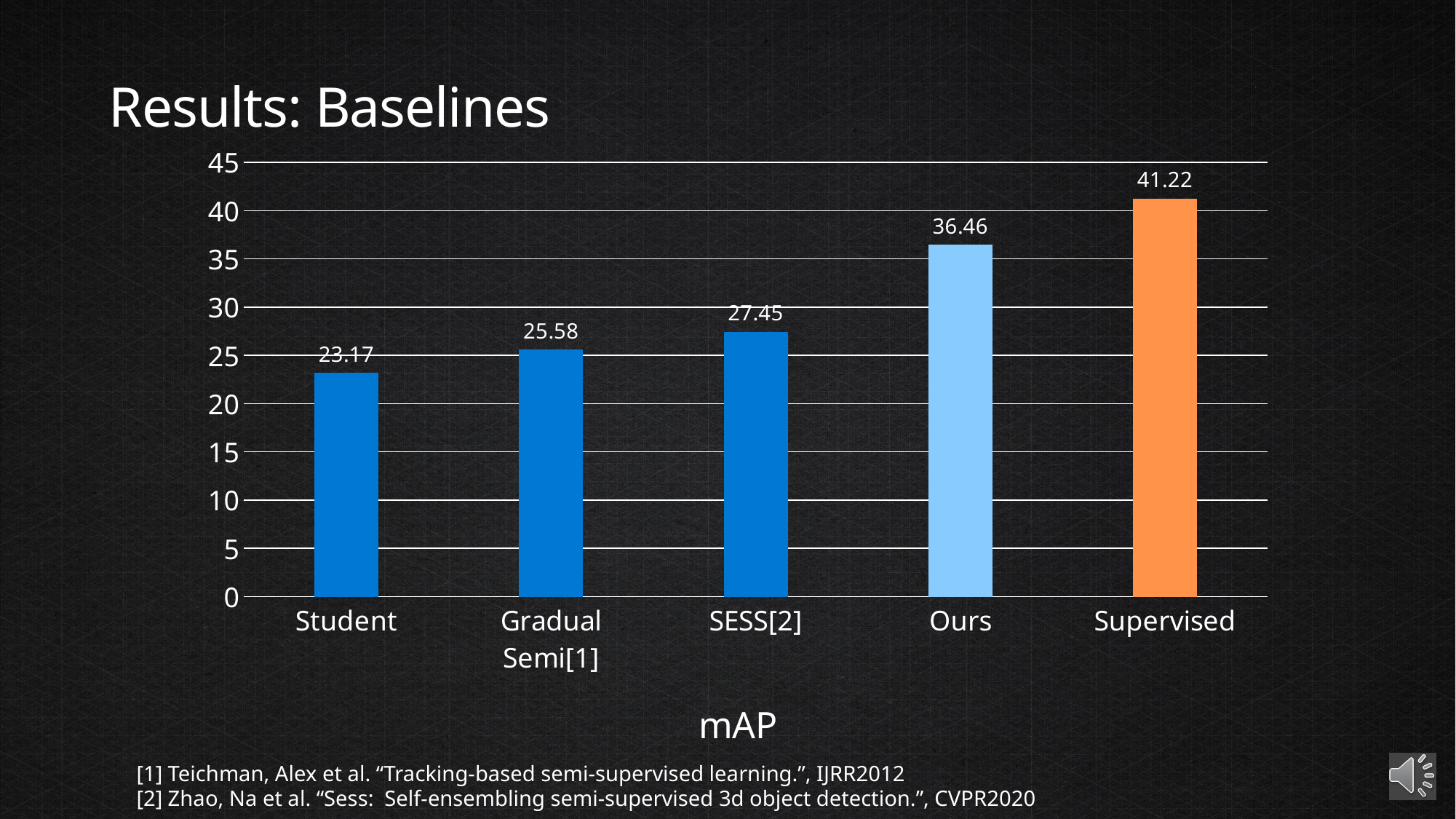
What kind of chart is shown on the slide? bar chart Is the mAP value for Ours greater or less than 35? greater What is the mAP value for Ours? 36.46 Which category has the highest mAP? Supervised Which has a higher mAP, Gradual Semi[1] or SESS[2]? SESS[2] What is the difference in mAP between Ours and SESS[2]? 9.01 How many categories are shown on the x axis? 5 What is the title of the chart? mAP What is the difference in mAP between Supervised and Ours? 4.76 What is the mAP value for SESS[2]? 27.45 Which category has the lowest mAP? Student What is the mAP value for Student? 23.17